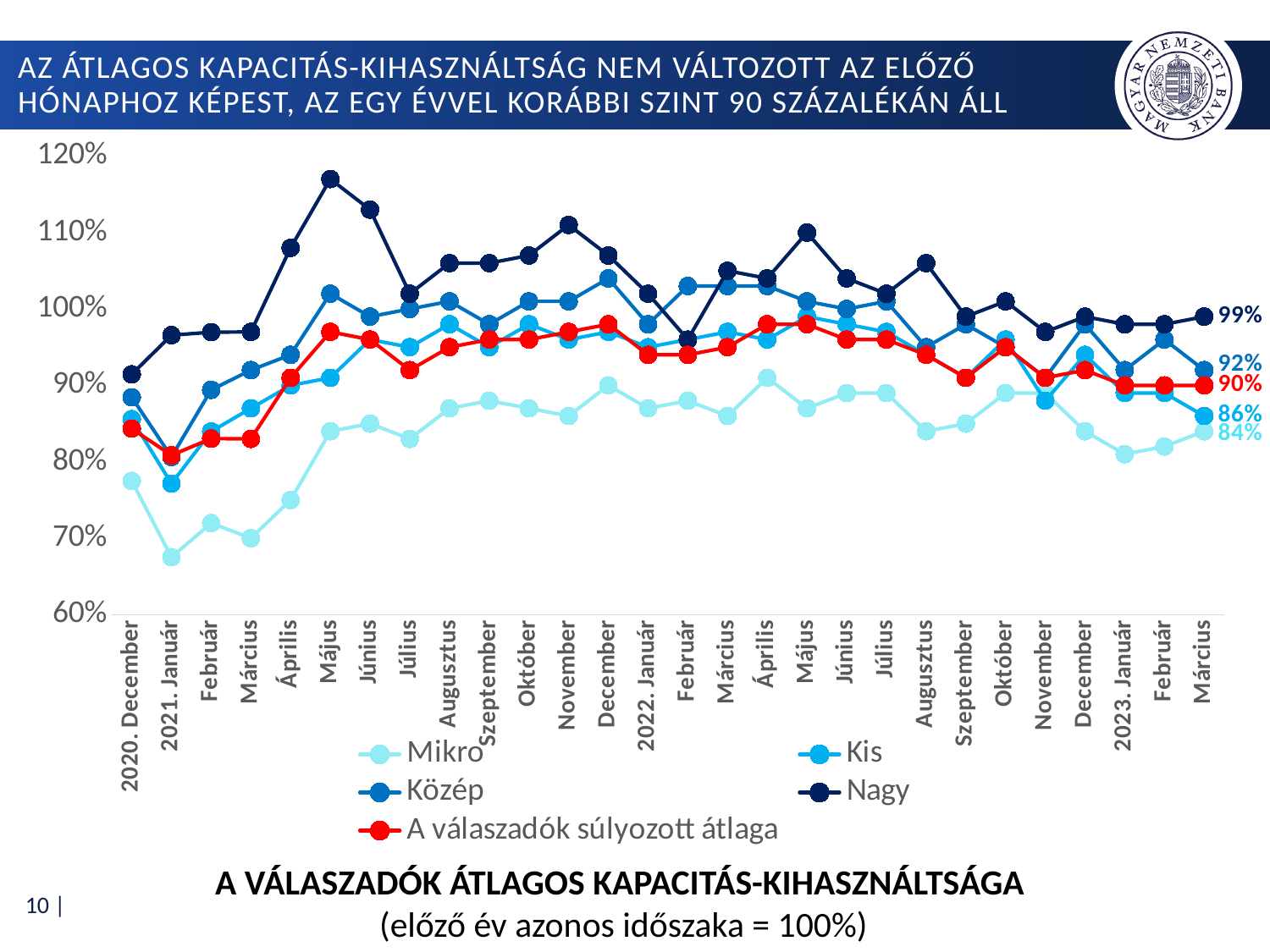
What type of chart is shown on the slide? line chart How many series does the legend list? 5 Is the value for Nagy in 2021 Május greater or less than 110%? greater Which series has the highest value in 2023 Március? Nagy What is the value for Mikro in 2023 Március? 84% What is the value for Nagy in 2023 Március? 99% What is the value for Közép in 2023 Március? 92% Is the value for Mikro in 2021 Január greater or less than 70%? less What is the value for Kis in 2023 Március? 86% What is the difference between the Nagy and Mikro values in 2023 Március? 15% What is the value for A válaszadók súlyozott átlaga in 2023 Március? 90% Which series has the lowest value in 2023 Március? Mikro